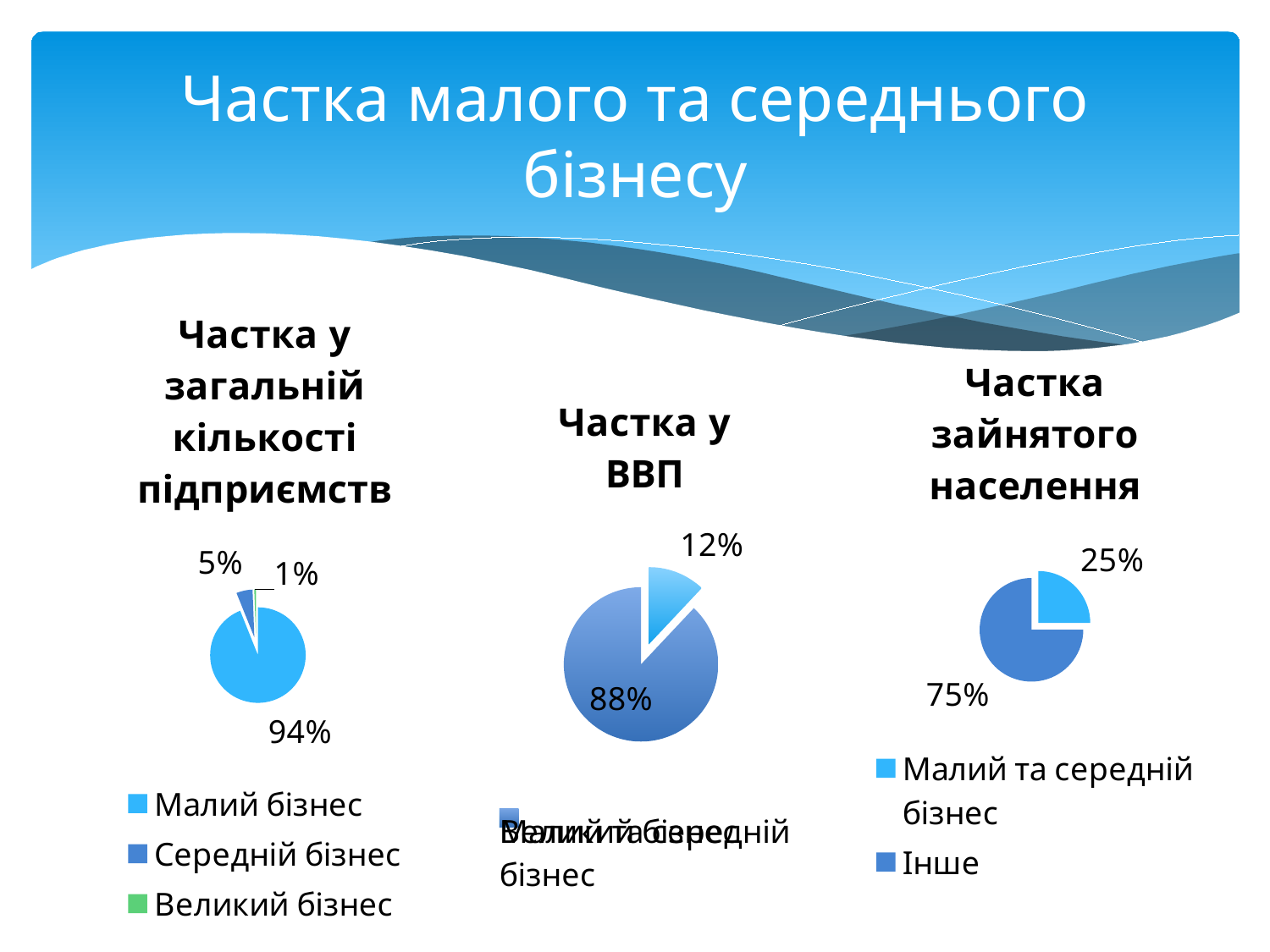
In the chart titled "Частка у ВВП", what is the value of the smaller slice? 12% In the chart titled "Частка у загальній кількості підприємств", which category has the largest share? Малий бізнес What type of chart is the chart titled "Частка зайнятого населення"? Pie chart In the chart titled "Частка зайнятого населення", what is the value for Малий та середній бізнес? 25% In the chart titled "Частка у загальній кількості підприємств", how many categories does the legend list? 3 In the chart titled "Частка у загальній кількості підприємств", what is the difference between the shares of Малий бізнес and Середній бізнес? 89% In the chart titled "Частка у загальній кількості підприємств", what is the value for Середній бізнес? 5% In the chart titled "Частка зайнятого населення", what is the value for Інше? 75% In the chart titled "Частка у ВВП", what is the value of the larger slice? 88% In the chart titled "Частка у загальній кількості підприємств", which category has the smallest share? Великий бізнес In the chart titled "Частка у загальній кількості підприємств", what is the value for Малий бізнес? 94% In the chart titled "Частка у загальній кількості підприємств", what is the value for Великий бізнес? 1%